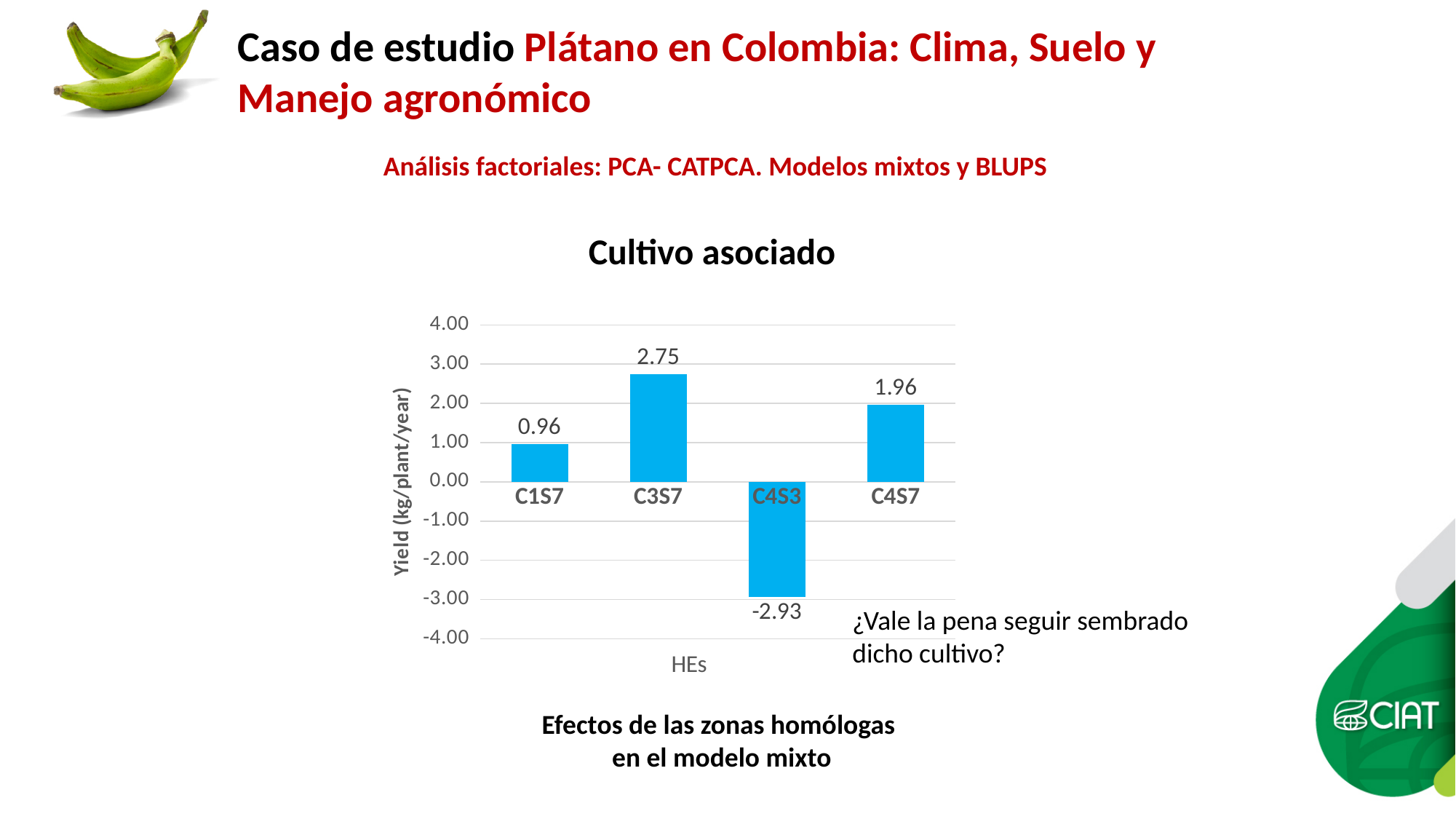
Which category has the highest value? C3S7 Is the value for C3S7 greater or less than 2.00? greater Which is larger, the value for C1S7 or the value for C4S7? C4S7 What is the title of the chart? Cultivo asociado Which category has the lowest value? C4S3 What kind of chart is shown? bar chart What is the value for C3S7? 2.75 What is the value for C4S3? -2.93 How many categories are shown on the x axis? 4 What is the difference between the values for C3S7 and C4S7? 0.79 What is the value for C1S7? 0.96 What is the value for C4S7? 1.96